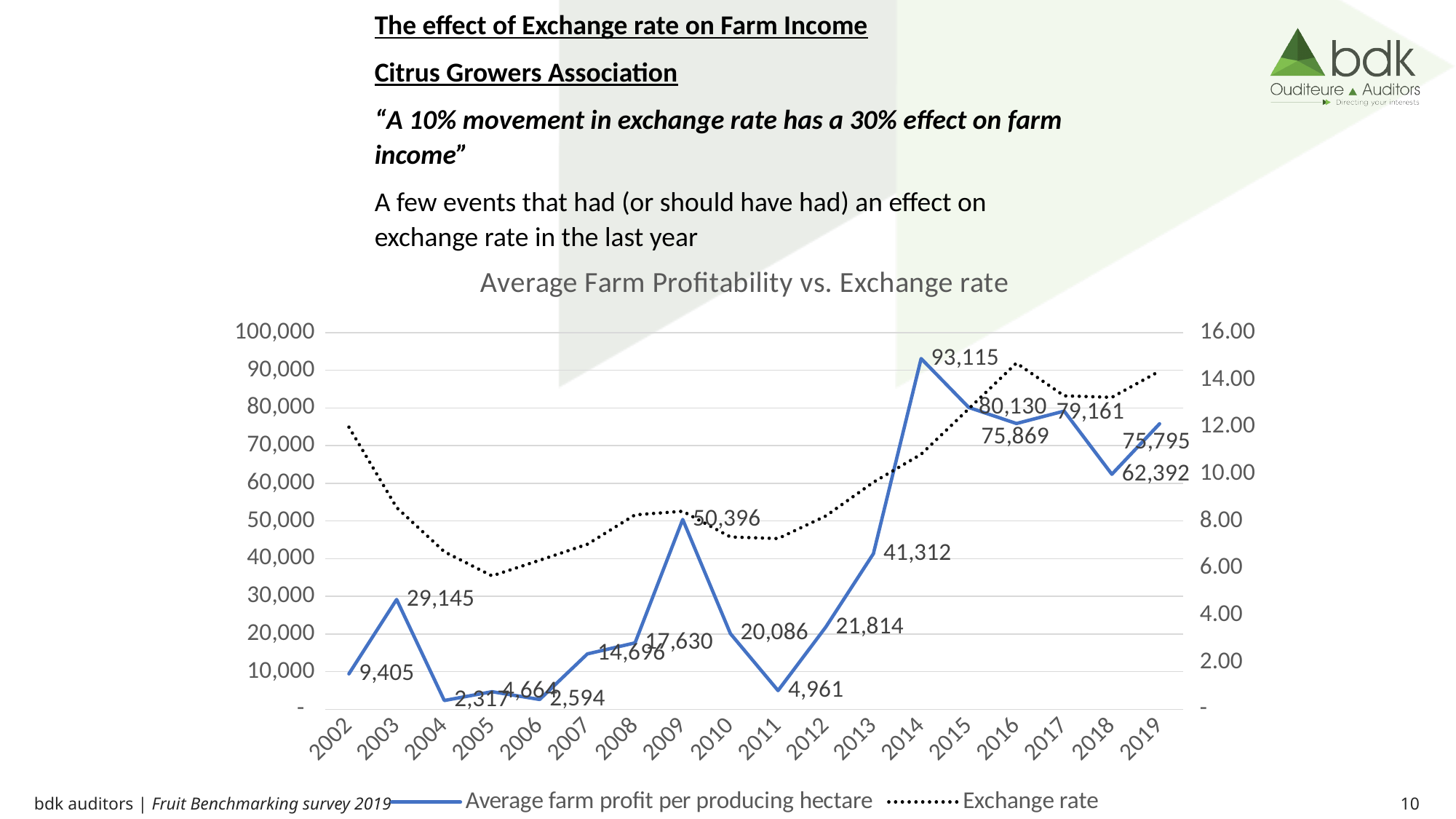
How many series does the legend list? 2 Is the exchange rate in 2005 greater or less than 8.00? less What is the average farm profit per producing hectare in 2014? 93,115 Which year has a higher average farm profit per producing hectare, 2016 or 2017? 2017 What is the average farm profit per producing hectare in 2018? 62,392 Which year has the lowest average farm profit per producing hectare? 2004 Which year has the highest average farm profit per producing hectare? 2014 How many years are plotted on the x axis? 18 Is the exchange rate in 2002 greater or less than 10.00? greater What kind of chart is shown on the slide? Line chart What is the difference in average farm profit per producing hectare between 2014 and 2015? 12,985 What is the average farm profit per producing hectare in 2009? 50,396